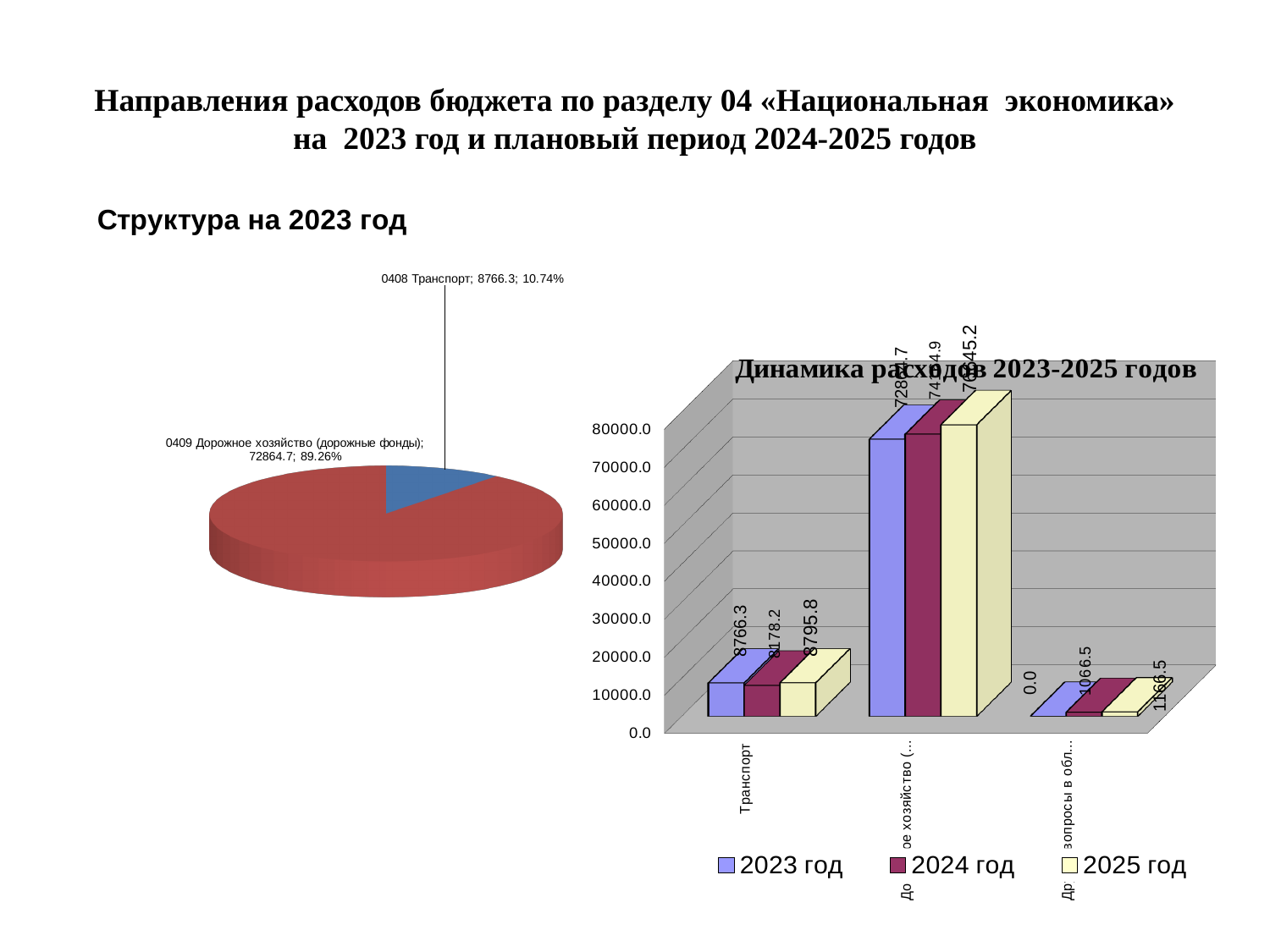
In the chart 'Динамика расходов 2023-2025 годов', what is the value for Транспорт in 2024 год? 8178.2 In the pie chart 'Структура на 2023 год', what share does '0408 Транспорт' have? 10.74% In the pie chart 'Структура на 2023 год', which slice is the largest? 0409 Дорожное хозяйство (дорожные фонды) What kind of chart is 'Динамика расходов 2023-2025 годов'? bar chart In the chart 'Динамика расходов 2023-2025 годов', what is the 2023 год value for the rightmost category? 0.0 In the chart 'Динамика расходов 2023-2025 годов', is the 2025 год value for Дорожное хозяйство greater or less than 70000.0? greater In the chart 'Динамика расходов 2023-2025 годов', which is larger for Транспорт: the 2023 год value or the 2024 год value? 2023 год In the chart 'Динамика расходов 2023-2025 годов', what is the difference between the 2025 год and 2024 год values for Транспорт? 617.6 In the chart 'Динамика расходов 2023-2025 годов', what is the value for Транспорт in 2025 год? 8795.8 In the chart 'Динамика расходов 2023-2025 годов', how many series does the legend list? 3 In the pie chart 'Структура на 2023 год', how many slices are there? 2 In the pie chart 'Структура на 2023 год', what is the value for '0409 Дорожное хозяйство (дорожные фонды)'? 72864.7